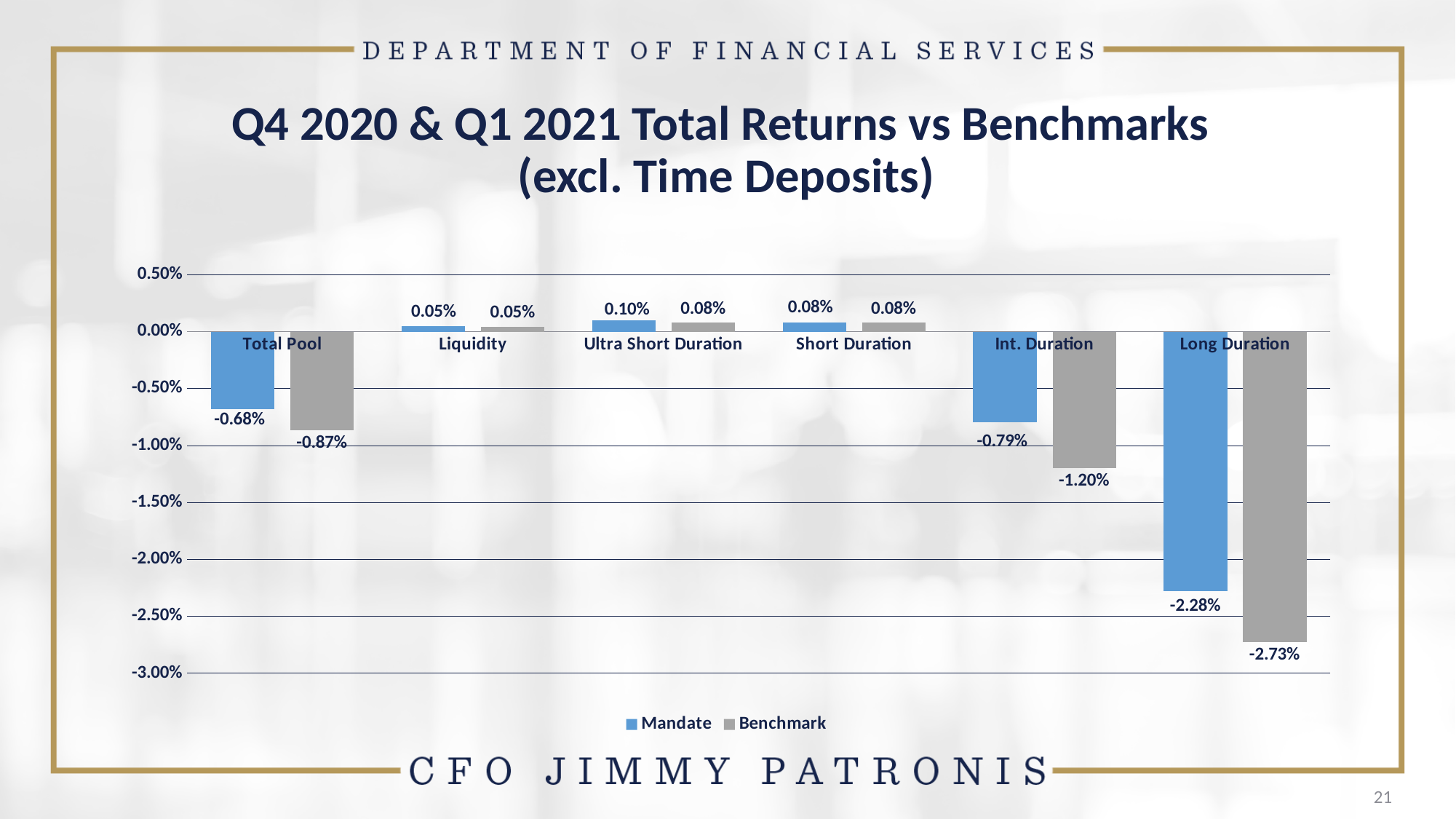
What kind of chart is shown on the slide? Bar chart Which colour represents the Benchmark series? Gray How many series does the legend list? 2 What is the Mandate value for Ultra Short Duration? 0.10% Which category has the lowest Mandate value? Long Duration What is the Mandate value for Total Pool? -0.68% How many categories are shown on the x axis? 6 What is the Benchmark value for Long Duration? -2.73% What is the difference between the Mandate and Benchmark values for Total Pool? 0.19% What is the Benchmark value for Int. Duration? -1.20% Which category has the highest Mandate value? Ultra Short Duration Which is larger for Int. Duration, the Mandate value or the Benchmark value? Mandate